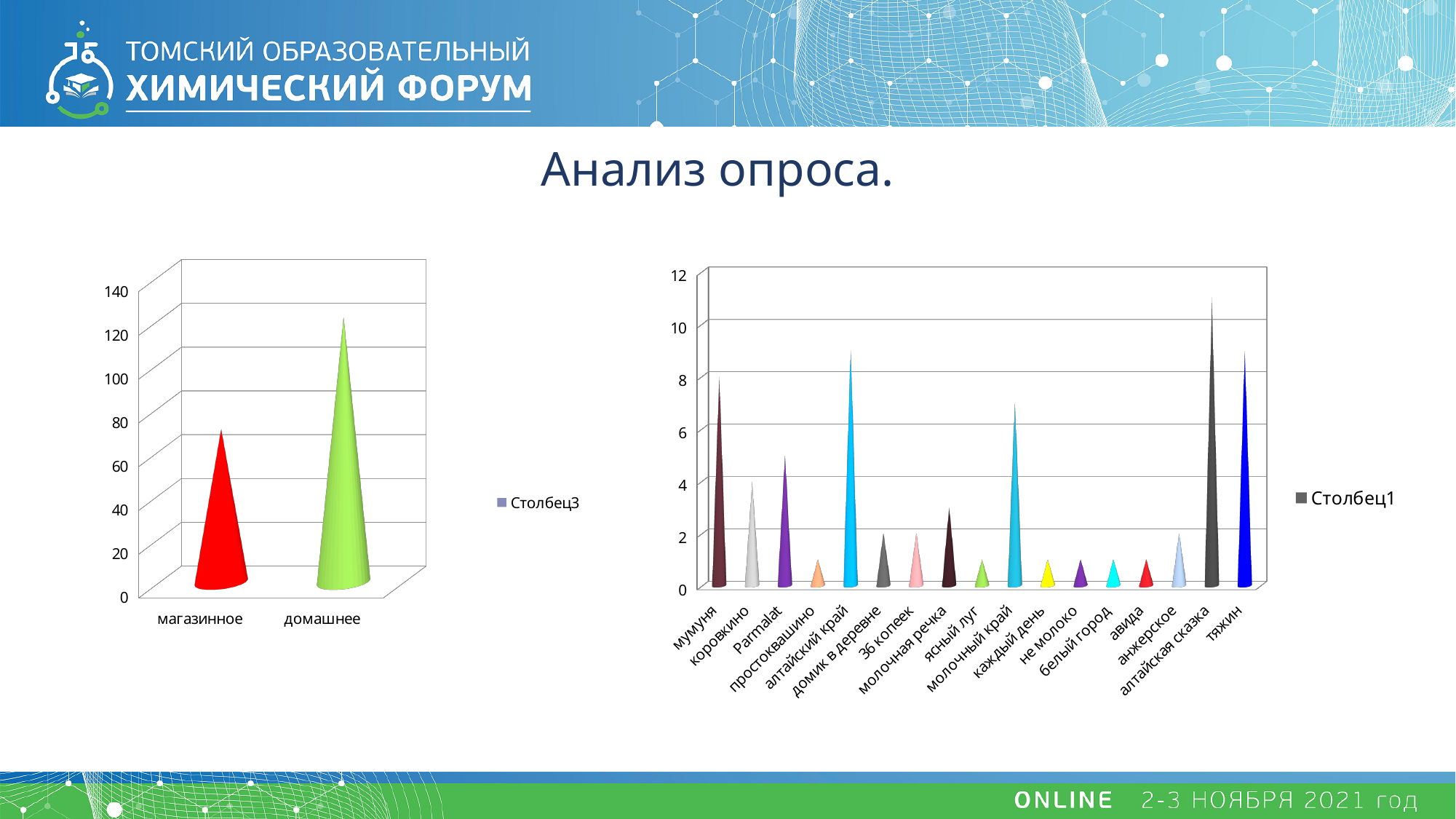
On the left chart, is the value for магазинное greater or less than 40? greater On the left chart, is the value for домашнее greater or less than 100? greater On the right chart, which has the larger value, мумуня or коровкино? мумуня What series name does the legend of the left chart list? Столбец3 On the right chart, is the value for алтайская сказка greater or less than 10? greater How many series does the legend of the right chart list? 1 How many categories does the right chart show? 17 On the left chart, which category has the higher value, магазинное or домашнее? домашнее On the right chart, which category has the highest value? алтайская сказка How many categories does the left chart show? 2